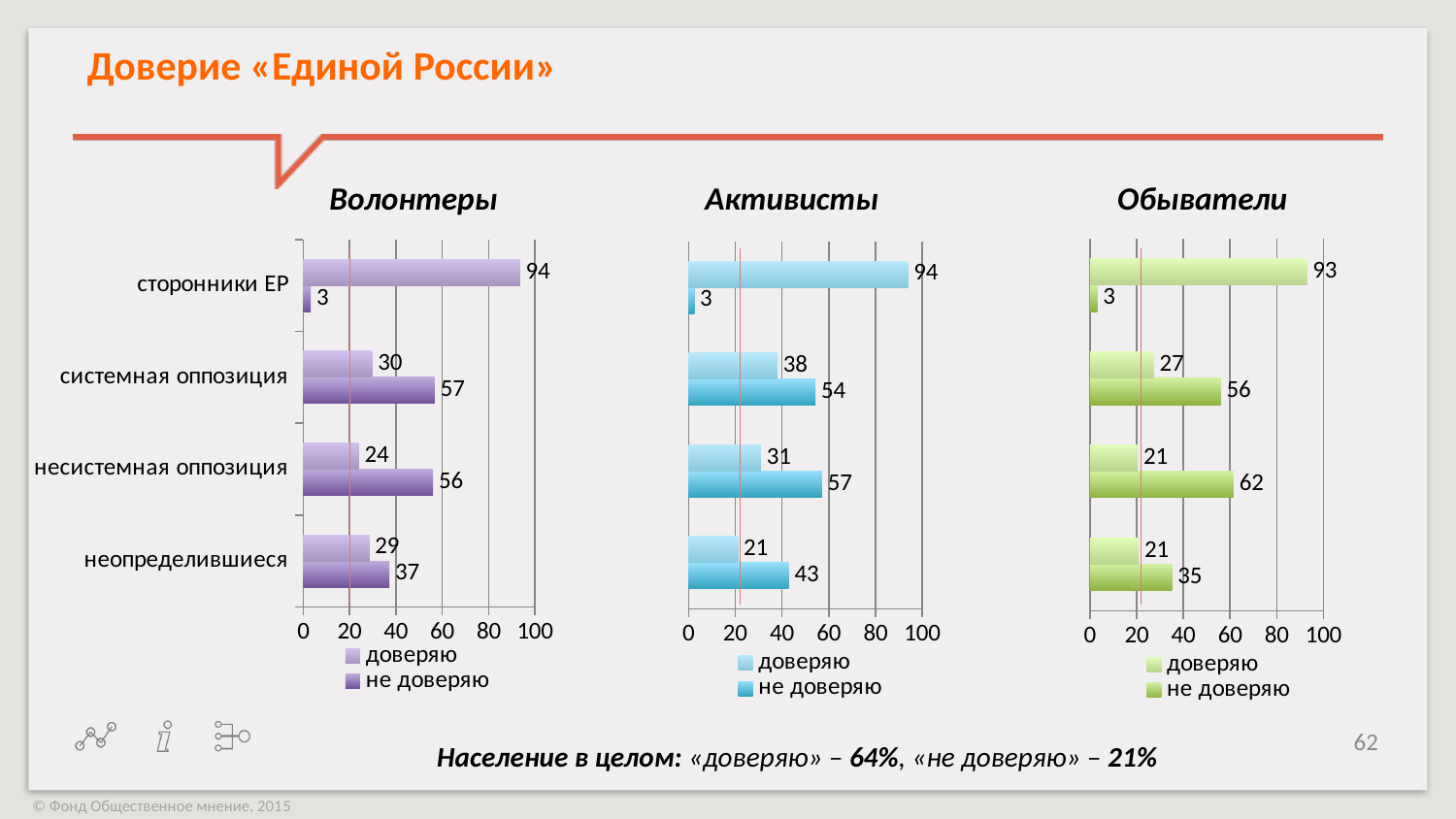
How many categories are shown in the Волонтеры chart? 4 In the Обыватели chart, what is the value of «доверяю» for системная оппозиция? 27 In the Обыватели chart, which category has the highest «не доверяю» value? несистемная оппозиция What is the title of the slide? Доверие «Единой России» In the Волонтеры chart, what is the value of «доверяю» for сторонники ЕР? 94 In the Активисты chart, which is larger for неопределившиеся: «доверяю» or «не доверяю»? не доверяю How many series does the legend of the Активисты chart list? 2 In the Обыватели chart, what is the difference between «не доверяю» and «доверяю» for неопределившиеся? 14 What kind of chart is the Обыватели chart? bar chart In the Активисты chart, what is the value of «не доверяю» for несистемная оппозиция? 57 In the Волонтеры chart, what is the difference between «не доверяю» and «доверяю» for системная оппозиция? 27 In the Активисты chart, which category has the lowest «доверяю» value? неопределившиеся